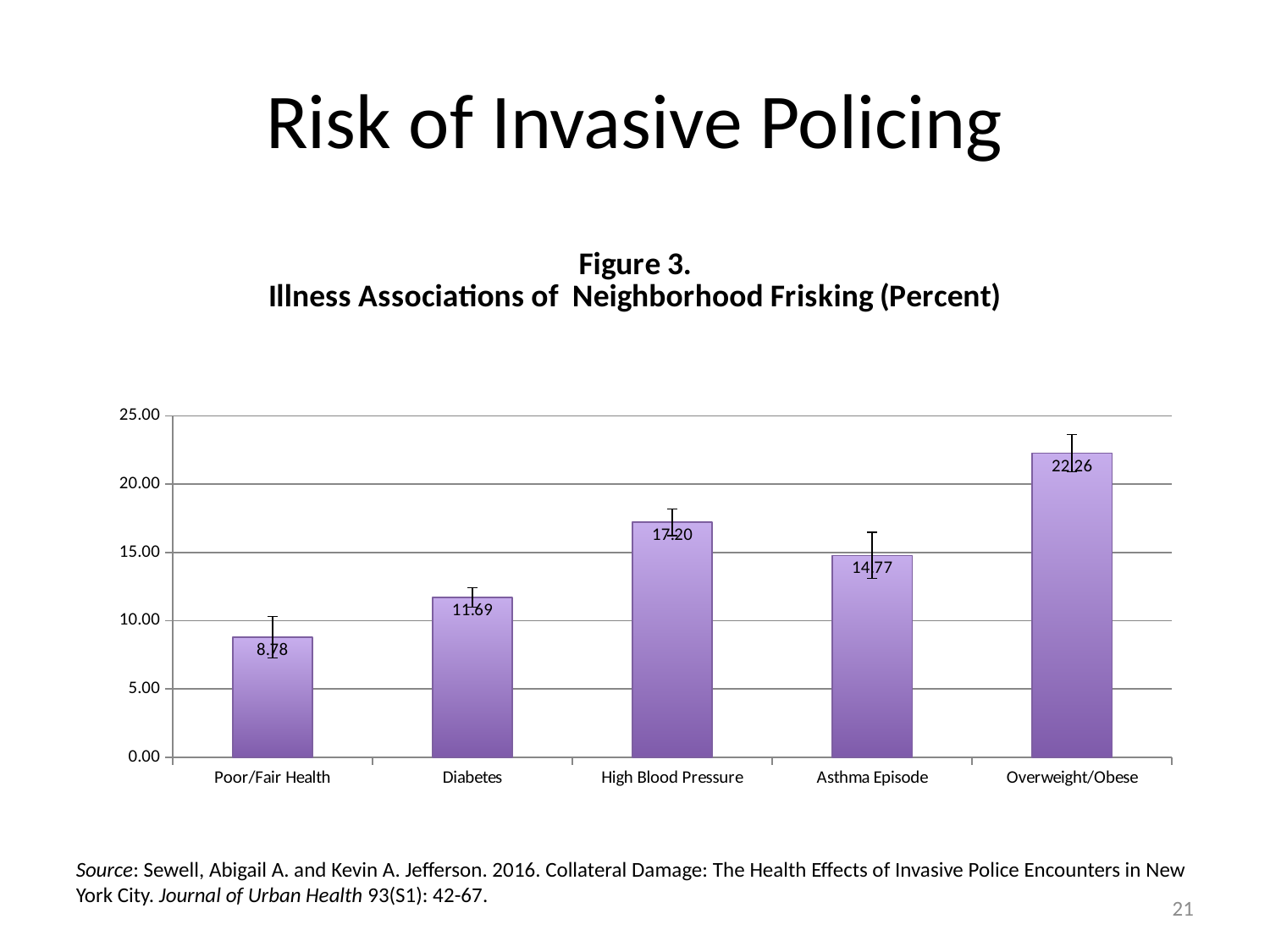
Which category has the highest value? Overweight/Obese Which is larger, the value for High Blood Pressure or the value for Asthma Episode? High Blood Pressure How many categories are shown on the x axis? 5 What is the value for Poor/Fair Health? 8.78 What is the difference between the values for Overweight/Obese and Poor/Fair Health? 13.48 Which category has the lowest value? Poor/Fair Health What kind of chart is shown on the slide? bar chart What is the value for Diabetes? 11.69 What is the value for Overweight/Obese? 22.26 What is the value for High Blood Pressure? 17.20 What is the title of the figure shown on the slide? Figure 3. Illness Associations of Neighborhood Frisking (Percent) Is the value for Asthma Episode greater or less than 15.00? less